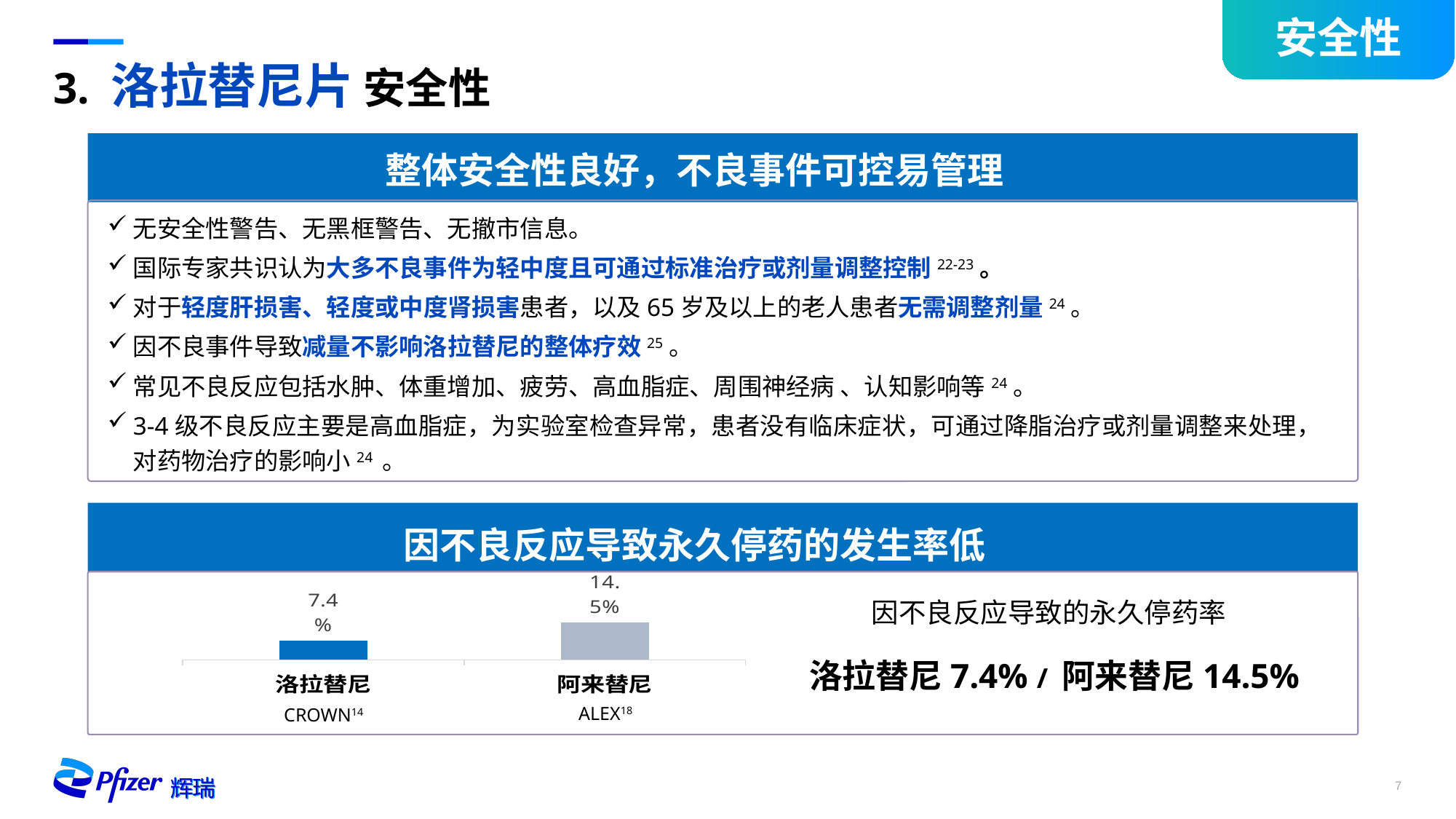
Which clinical trial is cited under the 洛拉替尼 bar in the chart? CROWN Which clinical trial is cited under the 阿来替尼 bar in the chart? ALEX Which drug has the lower permanent discontinuation rate in the bar chart? 洛拉替尼 What is the permanent discontinuation rate due to adverse reactions shown for 阿来替尼 in the bar chart? 14.5% What is the difference between the discontinuation rates of 阿来替尼 and 洛拉替尼 in the bar chart? 7.1% Which drug has the higher permanent discontinuation rate in the bar chart? 阿来替尼 How many drugs (categories) are plotted in the bar chart? 2 What is the permanent discontinuation rate due to adverse reactions shown for 洛拉替尼 in the bar chart? 7.4% What type of chart is used to show the permanent discontinuation rates? bar chart Is the discontinuation rate for 洛拉替尼 larger or smaller than that for 阿来替尼? smaller